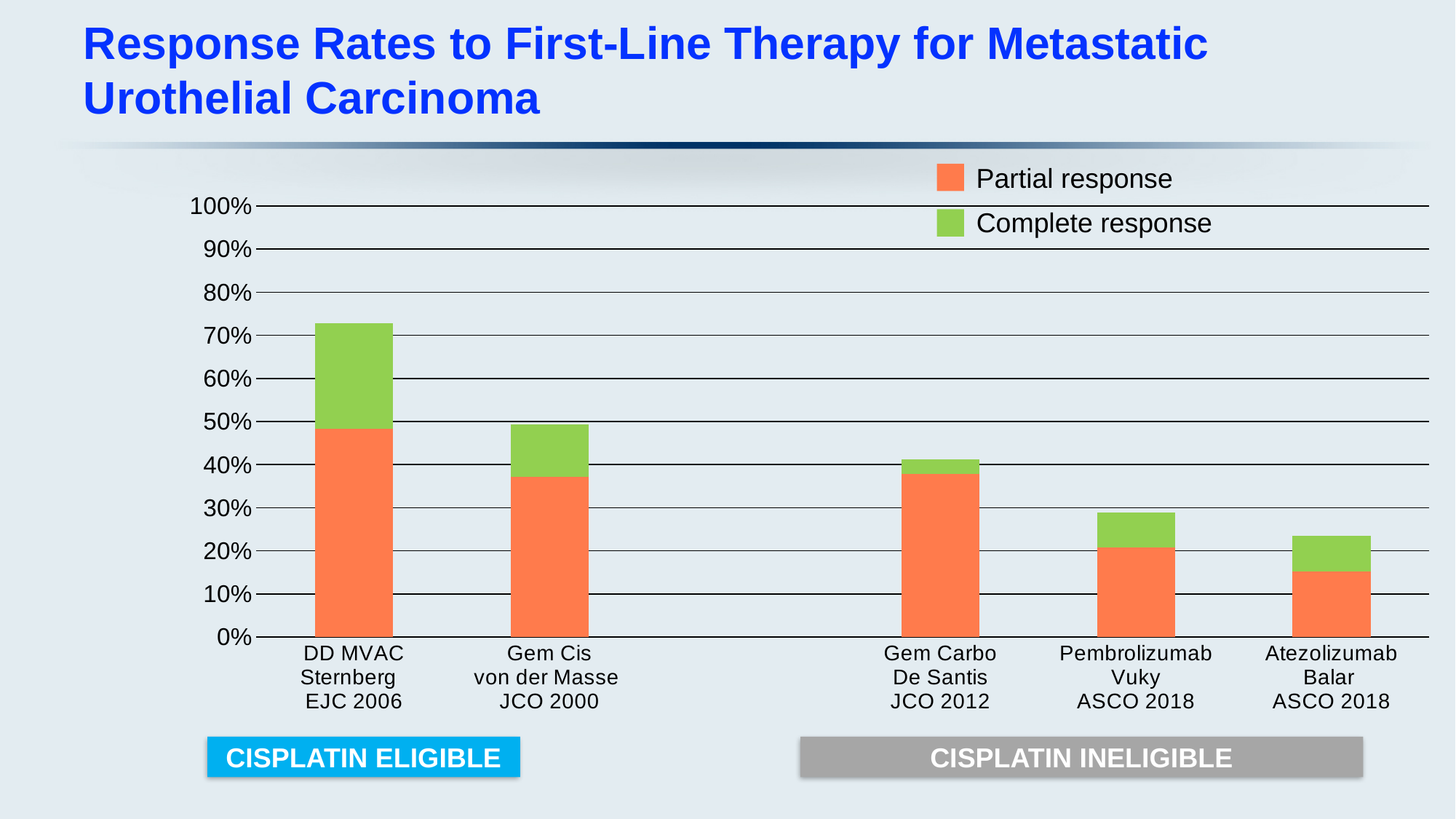
Is the total response rate for DD MVAC greater or less than 70%? greater Is the partial response rate for Atezolizumab greater or less than 20%? less How many therapy categories are plotted along the x axis? 5 Which therapy has the highest total response rate? DD MVAC Which has a larger total response rate, Gem Carbo or Pembrolizumab? Gem Carbo Which colour represents Complete response in the chart? Green What kind of chart is shown on the slide? Stacked bar chart How many series does the legend list? 2 Which two therapies are grouped under the Cisplatin Eligible label? DD MVAC and Gem Cis Which therapy has the lowest total response rate? Atezolizumab Is the total response rate for Pembrolizumab greater or less than 30%? less